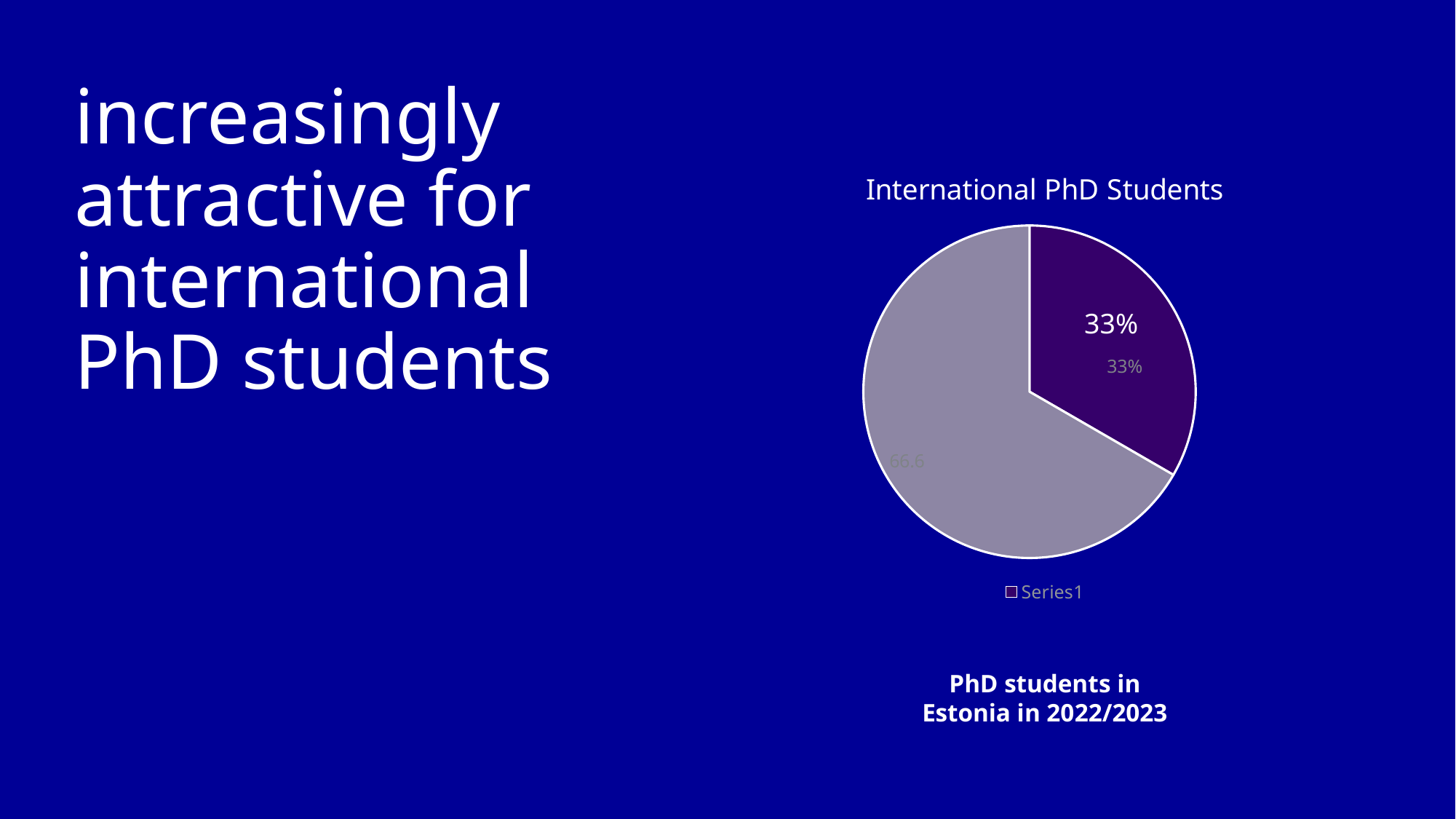
What is the name of the series shown in the legend? Series1 Which slice of the pie chart is larger, the grey slice or the dark purple slice? the grey slice What kind of chart is shown on the slide? pie chart How many slices does the pie chart have? 2 What percentage is printed on the dark purple slice of the pie chart? 33% What is the title of the chart? International PhD Students Which slice of the pie chart is the smallest? the dark purple slice How many series does the chart legend list? 1 Which slice of the pie chart is the largest? the grey slice According to the caption below the chart, which country and academic year does the chart refer to? Estonia in 2022/2023 What value is printed on the grey slice of the pie chart? 66,6 What share of the pie does the dark purple slice represent? 33%